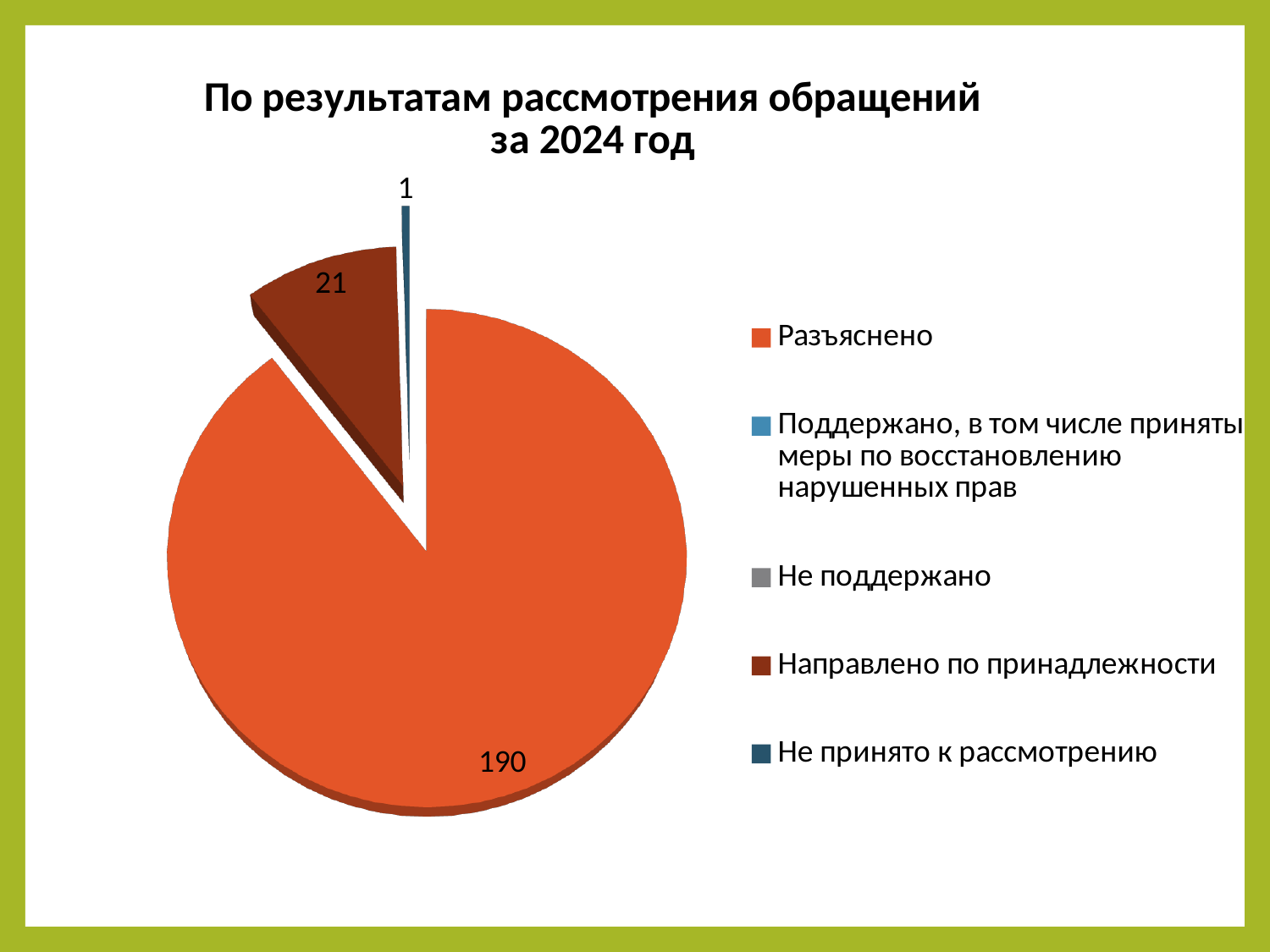
Which labelled slice has the smallest value? Не принято к рассмотрению Which category has the largest slice of the pie? Разъяснено What is the title of the chart? По результатам рассмотрения обращений за 2024 год Which is larger: Направлено по принадлежности or Не принято к рассмотрению? Направлено по принадлежности What kind of chart is shown on the slide? Pie chart What is the difference between the Разъяснено value and the Направлено по принадлежности value? 169 What value is shown for the Разъяснено slice? 190 What value is shown for the Направлено по принадлежности slice? 21 How many categories does the legend list? 5 What colour is the Разъяснено slice? Orange What is the difference between the Направлено по принадлежности value and the Не принято к рассмотрению value? 20 What value is shown for the Не принято к рассмотрению slice? 1